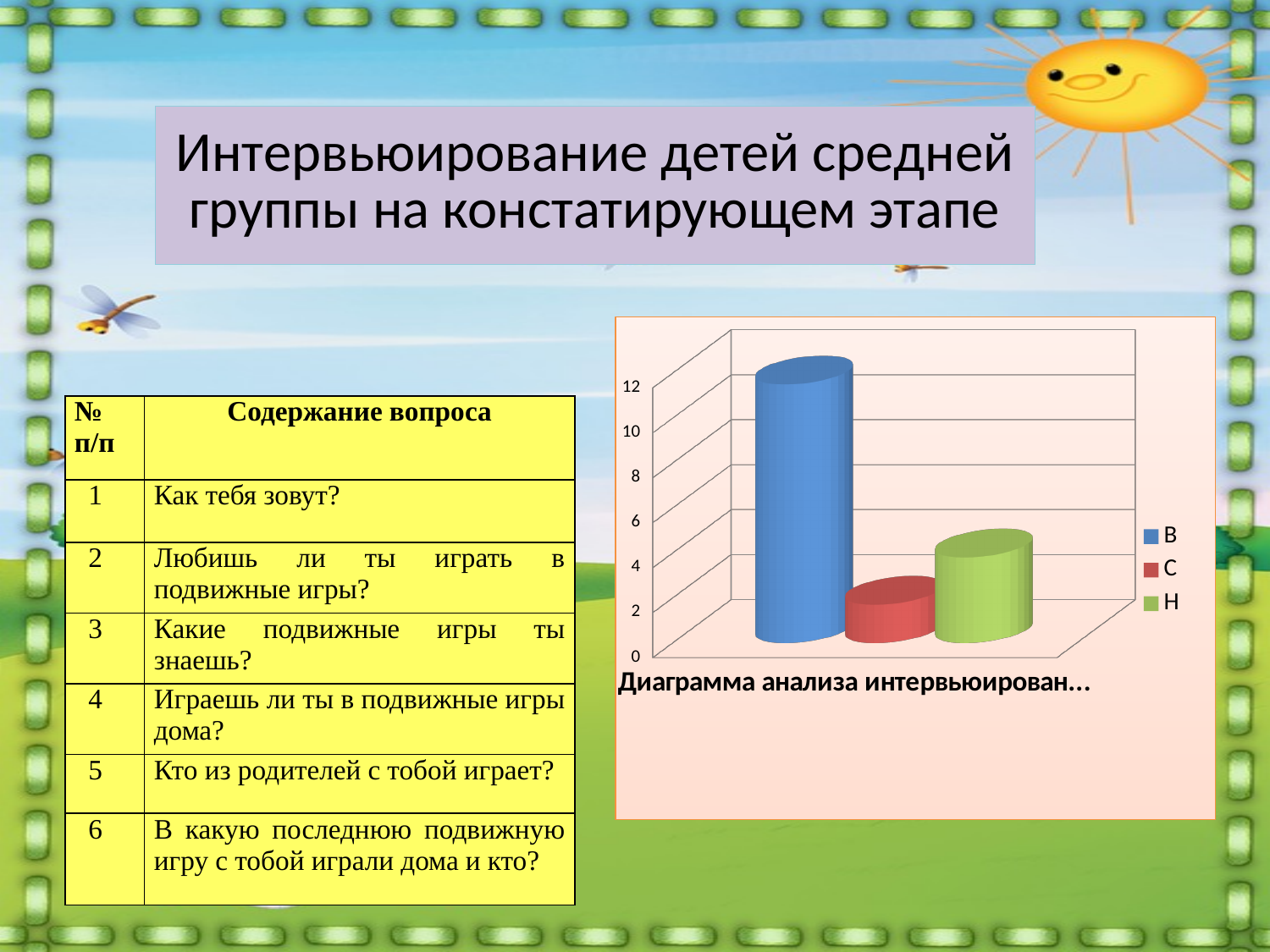
What are the series names listed in the chart legend? В, С, Н Is the value for Н greater or less than 2? greater What colour is the bar for series В? blue How many series does the chart legend list? 3 Which is larger, the value for Н or the value for С? Н Which series has the highest bar in the chart? В Which series has the lowest bar in the chart? С Is the value for В greater or less than 8? greater What kind of chart is shown on the slide? bar chart Is the value for С greater or less than 4? less What is the highest value shown on the chart's vertical axis? 12